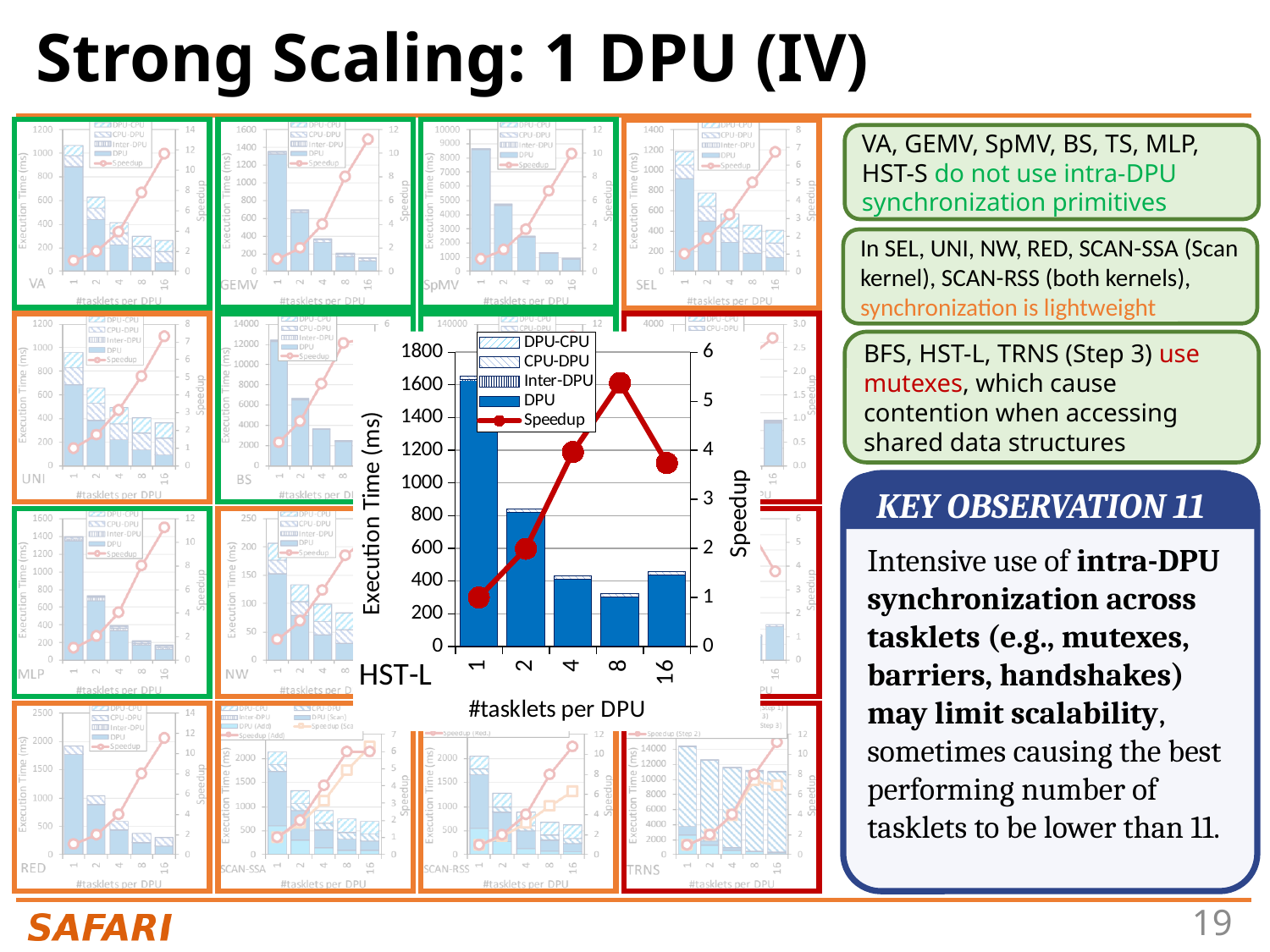
In the enlarged HST-L chart, which has the larger execution time: 8 tasklets per DPU or 16 tasklets per DPU? 16 In the enlarged HST-L chart, is the execution time for 1 tasklet per DPU greater or less than 1400 ms? greater In the enlarged HST-L chart, which number of tasklets per DPU has the highest execution time? 1 In the enlarged HST-L chart, which number of tasklets per DPU has the lowest execution time? 8 In the enlarged HST-L chart, what kind of chart is used to show execution time? bar chart In the enlarged HST-L chart, at which number of tasklets per DPU is the speedup highest? 8 In the enlarged HST-L chart, is the speedup for 8 tasklets per DPU greater or less than 5? greater In the enlarged HST-L chart, does the speedup rise or fall from 8 to 16 tasklets per DPU? fall In the enlarged HST-L chart, how many entries does the legend list? 5 In the enlarged HST-L chart, what is the label of the x axis? #tasklets per DPU In the enlarged HST-L chart, is the execution time for 2 tasklets per DPU greater or less than 1000 ms? less In the enlarged HST-L chart, how many tasklet counts are shown on the x axis? 5